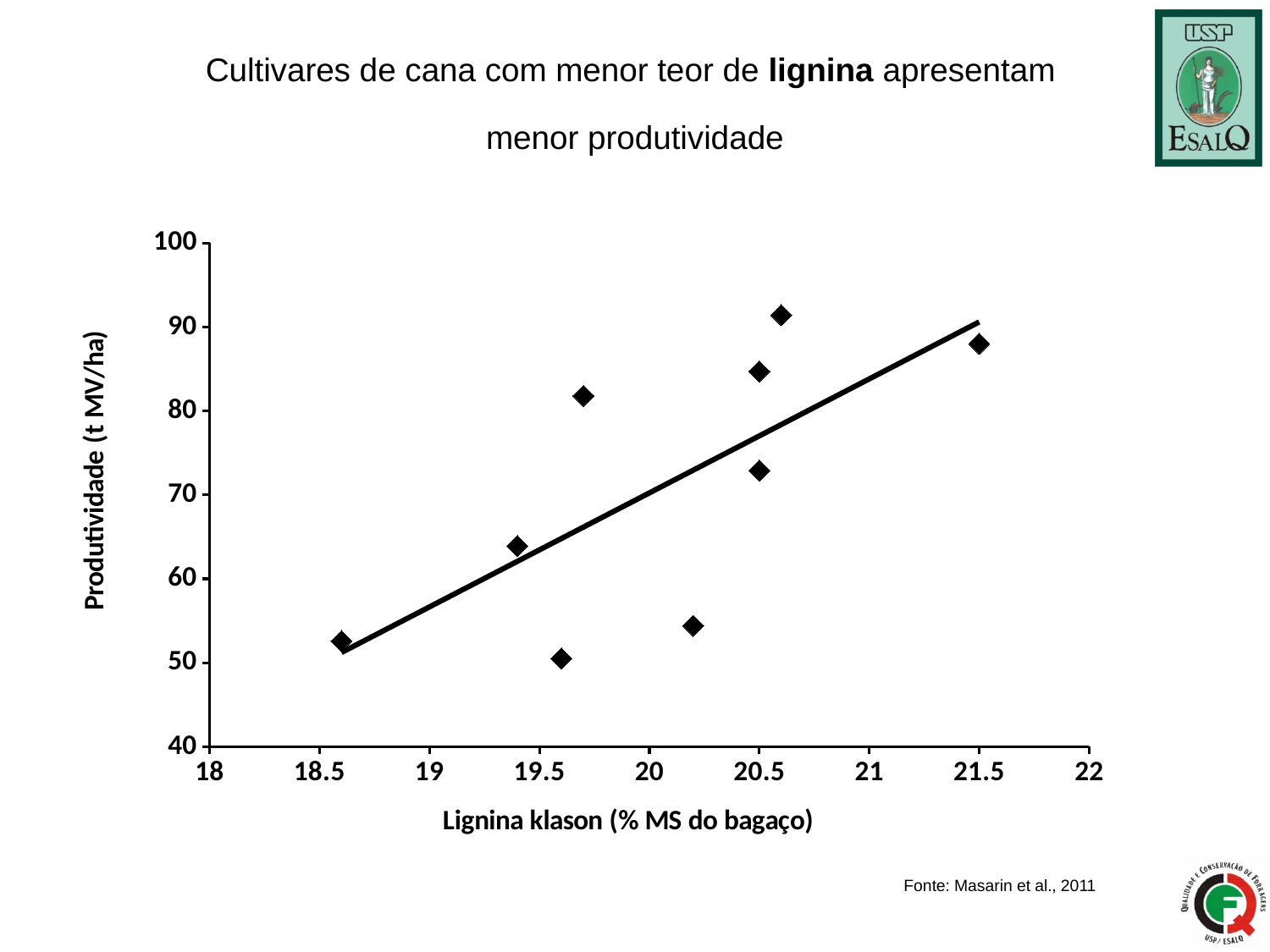
Is the productivity of the highest point on the chart greater or less than 90 t MV/ha? greater Does productivity tend to rise or fall as Klason lignin increases along the x axis? Rise What is the label of the y axis? Produtividade (t MV/ha) What is the maximum value shown on the y axis? 100 How many data points are plotted on the chart? 9 What is the label of the x axis? Lignina klason (% MS do bagaço) Is the productivity of the point at 21.5% Klason lignin greater or less than 80 t MV/ha? greater Is the productivity of the point with the lowest Klason lignin greater or less than 60 t MV/ha? less What is the minimum value shown on the x axis? 18 What kind of chart is shown on the slide? Scatter plot